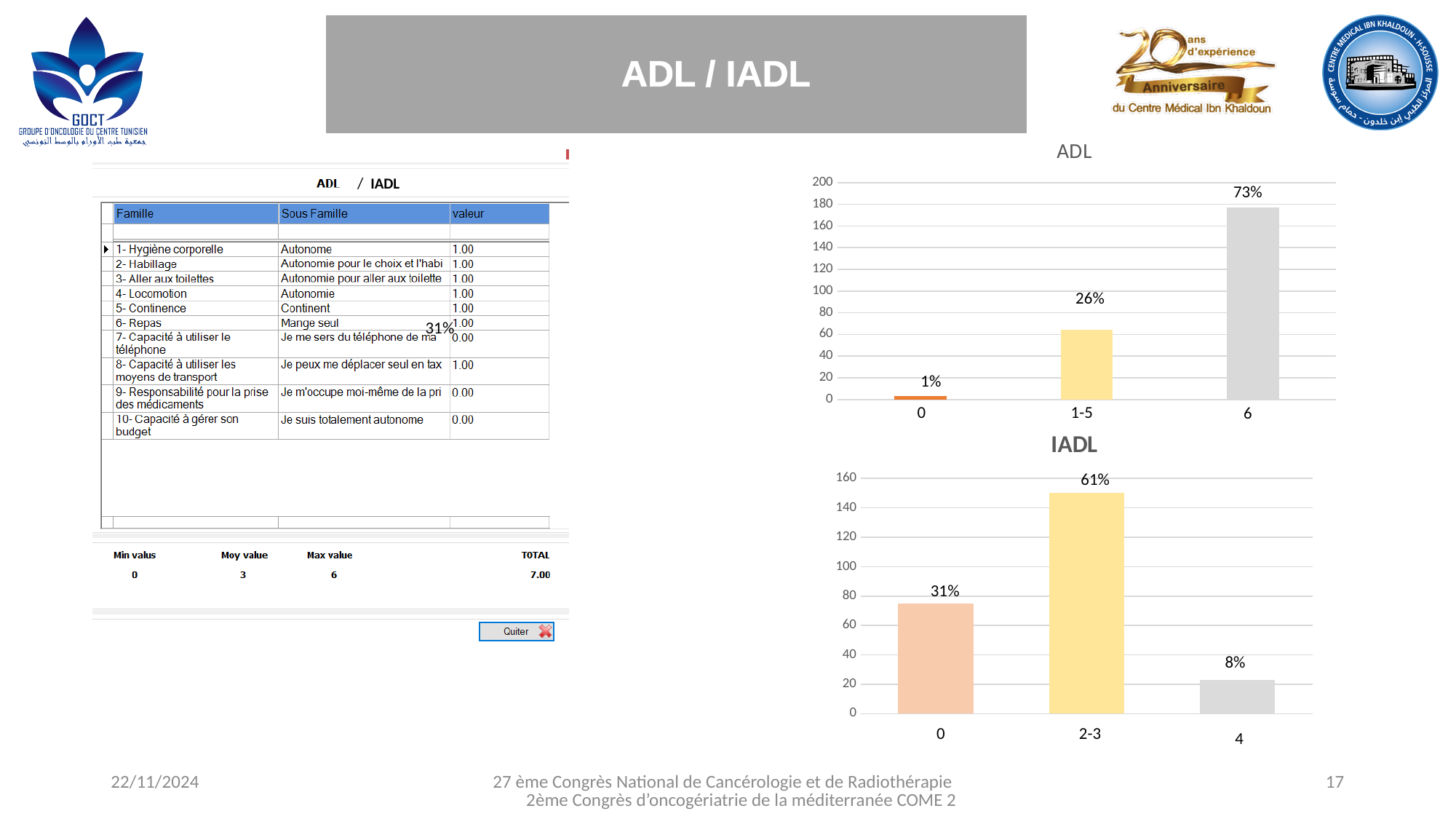
In the ADL chart, what data label is shown on the bar for category 1-5? 26% In the IADL chart, is the bar for category 2-3 greater or less than 140 on the axis? greater In the ADL chart, is the bar for category 1-5 greater or less than 80 on the axis? less In the ADL chart, what data label is shown on the bar for category 6? 73% In the ADL chart, which category has the tallest bar? 6 How many categories are shown on the x axis of the IADL chart? 3 In the IADL chart, what data label is shown on the bar for category 4? 8% In the IADL chart, which category has the shortest bar? 4 In the IADL chart, what data label is shown on the bar for category 2-3? 61% What type of chart is the ADL chart? Bar chart In the IADL chart, which bar is taller: category 0 or category 4? 0 In the ADL chart, what data label is shown on the bar for category 0? 1%